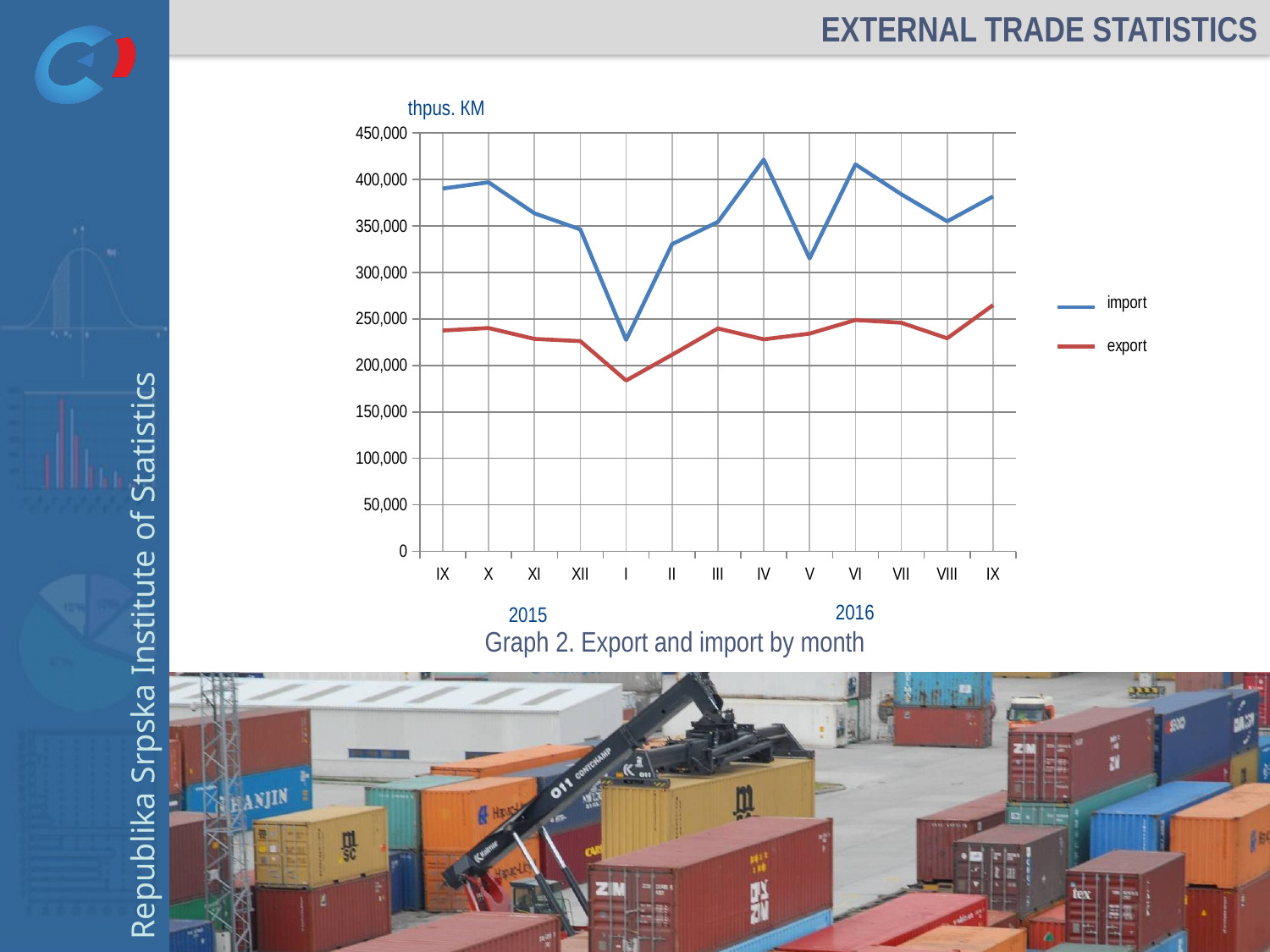
How many series does the legend list? 2 Is the import value for I 2016 greater or less than 250,000? less In which month is the export value lowest? I 2016 Is the import value for IX 2015 greater or less than 350,000? greater Which is larger in IV 2016, import or export? import What is the title of the chart? Graph 2. Export and import by month What kind of chart is shown on the slide? line chart Does the export value rise or fall from VIII 2016 to IX 2016? rise In which month is the import value lowest? I 2016 Is the export value for IX 2016 greater or less than 250,000? greater In which month is the export value highest? IX 2016 How many months are plotted along the x axis? 13